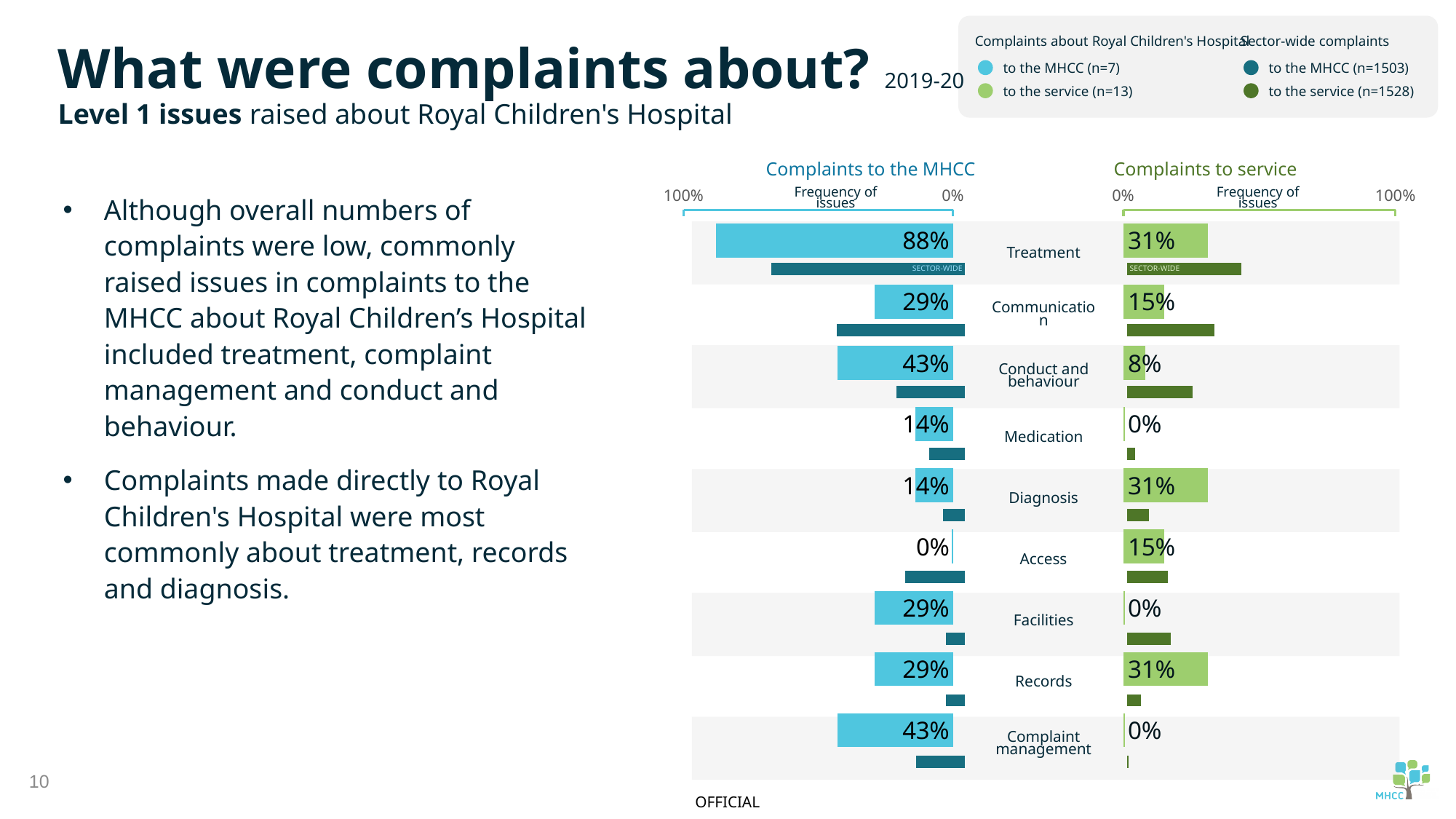
In the 'Complaints to service' chart, what is the value for Records? 31% In the 'Complaints to service' chart, which is larger, the value for Diagnosis or the value for Access? Diagnosis In the 'Complaints to the MHCC' chart, which category has the lowest value? Access How many categories are shown in the 'Complaints to the MHCC' chart? 9 What kind of chart is the 'Complaints to service' chart? Bar chart In the 'Complaints to the MHCC' chart, which is larger, the value for Communication or the value for Medication? Communication In the 'Complaints to the MHCC' chart, what is the value for Complaint management? 43% In the 'Complaints to the MHCC' chart, which category has the highest value? Treatment In the 'Complaints to the MHCC' chart, what is the value for Treatment? 88% In the 'Complaints to the MHCC' chart, what is the difference between the values for Treatment and Conduct and behaviour? 45% In the 'Complaints to service' chart, what is the difference between the values for Treatment and Communication? 16% In the 'Complaints to service' chart, what is the value for Conduct and behaviour? 8%